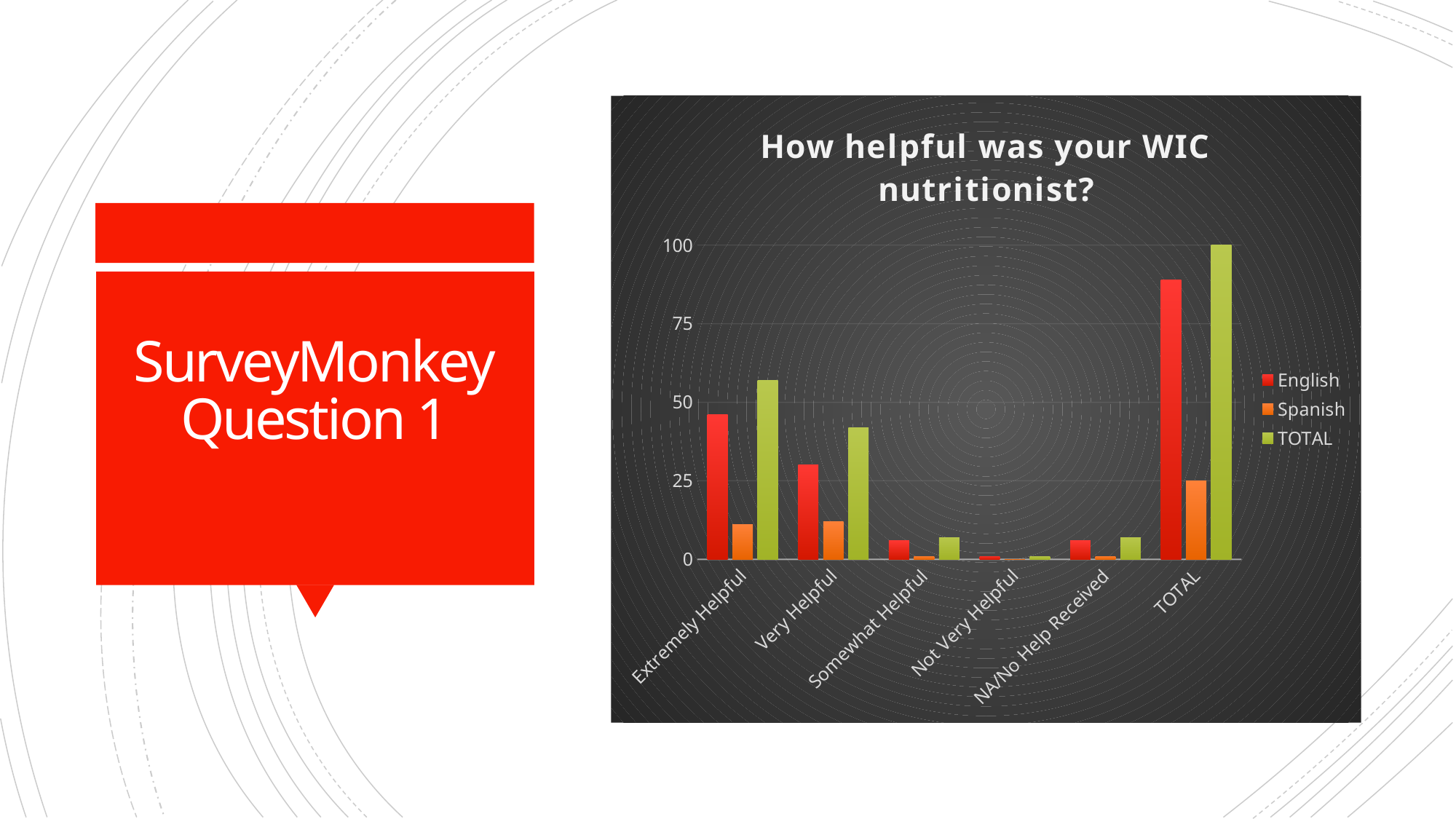
Excluding the TOTAL category, which category has the highest TOTAL series value? Extremely Helpful What kind of chart is shown on the slide? bar chart Is the English value for Extremely Helpful greater or less than 25? greater Which is larger for Very Helpful, the English value or the Spanish value? English Is the English value for the TOTAL category greater or less than 75? greater What is the Spanish value for the TOTAL category? 25 How many categories are shown on the x axis? 6 What is the title of the chart? How helpful was your WIC nutritionist? Which category has the lowest TOTAL series value? Not Very Helpful How many series does the legend list? 3 Is the TOTAL series value for Extremely Helpful greater or less than 50? greater